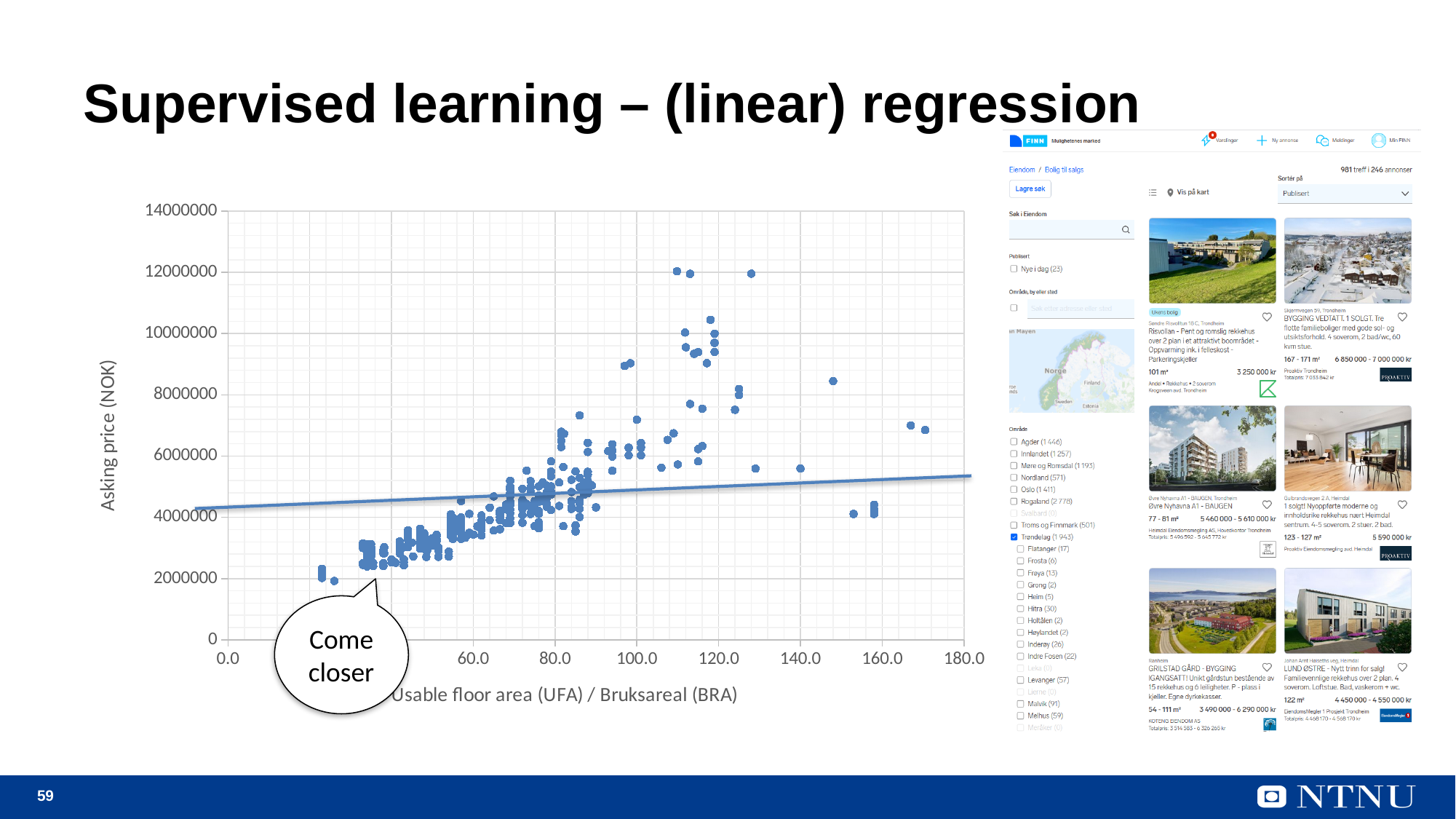
Where the trend line meets the left edge of the chart at 0.0, is its value greater or less than 2000000? greater Is the asking price of the lowest point in the chart greater or less than 4000000? less Where the trend line meets the right edge of the chart at 180.0, is its value greater or less than 6000000? less Does the fitted trend line in the chart rise or fall as usable floor area increases? Rises Are there more data points with usable floor area below 100.0 or above 100.0? Below 100.0 What is the highest value shown on the y axis of the chart? 14000000 What is the highest value shown on the x axis of the chart? 180.0 What is the label of the x axis of the chart? Usable floor area (UFA) / Bruksareal (BRA) What kind of chart is shown on the slide? Scatter plot What is the label of the y axis of the chart? Asking price (NOK)